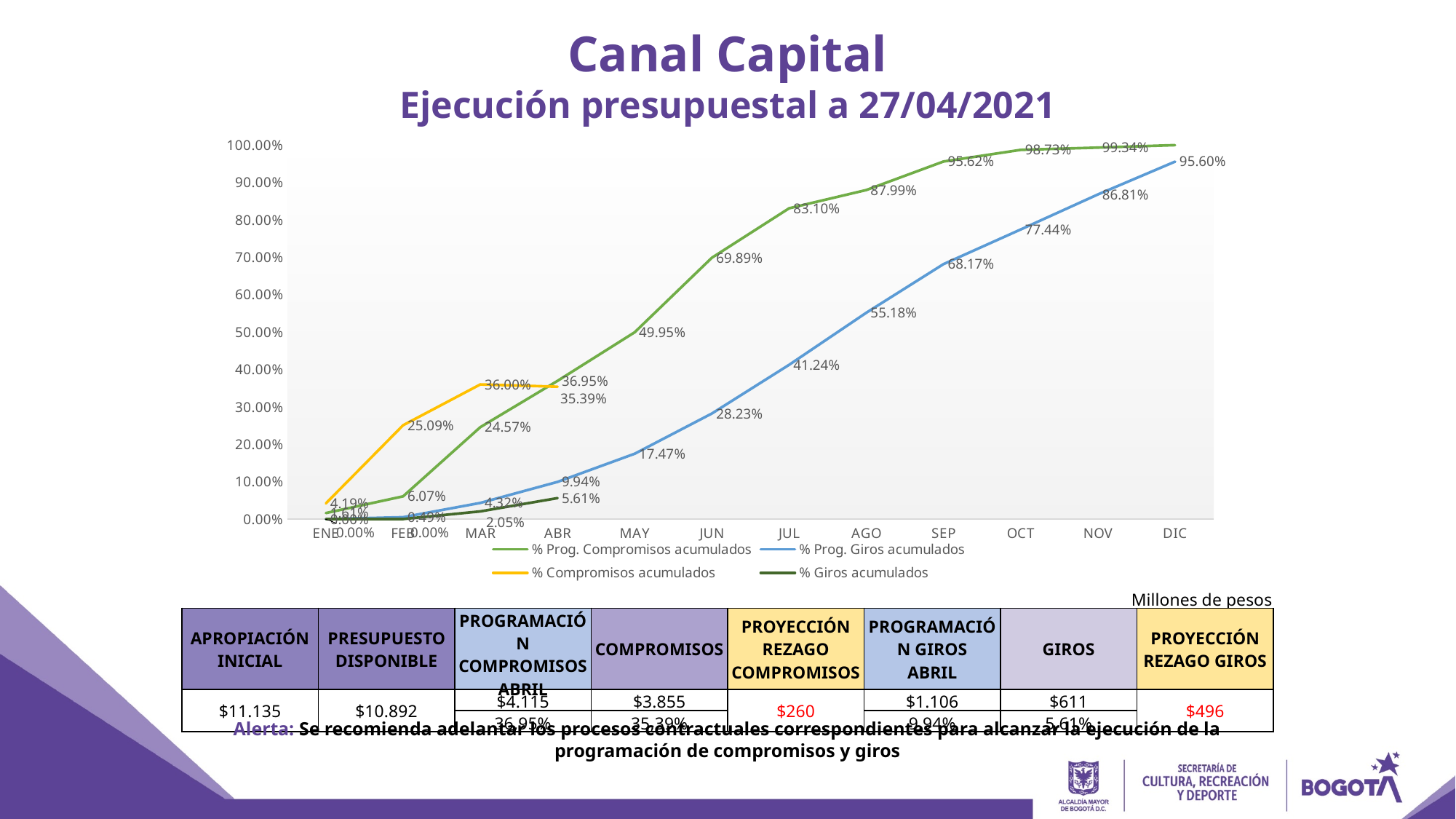
Which is larger in MAR: % Compromisos acumulados or % Prog. Compromisos acumulados? % Compromisos acumulados What is the value of % Prog. Compromisos acumulados in JUL? 83.10% What colour is the line for % Compromisos acumulados? yellow What is the value of % Compromisos acumulados in FEB? 25.09% How many months are shown on the x axis of the chart? 12 What type of chart is shown on the slide? line chart Is the value of % Prog. Giros acumulados in OCT greater or less than 70.00%? greater Does the % Prog. Giros acumulados series rise or fall from ENE to DIC? rise How many series does the chart legend list? 4 What is the value of % Giros acumulados in ABR? 5.61% What is the value of % Prog. Giros acumulados in DIC? 95.60% What is the difference between % Prog. Compromisos acumulados in SEP (95.62%) and in AGO (87.99%)? 7.63%